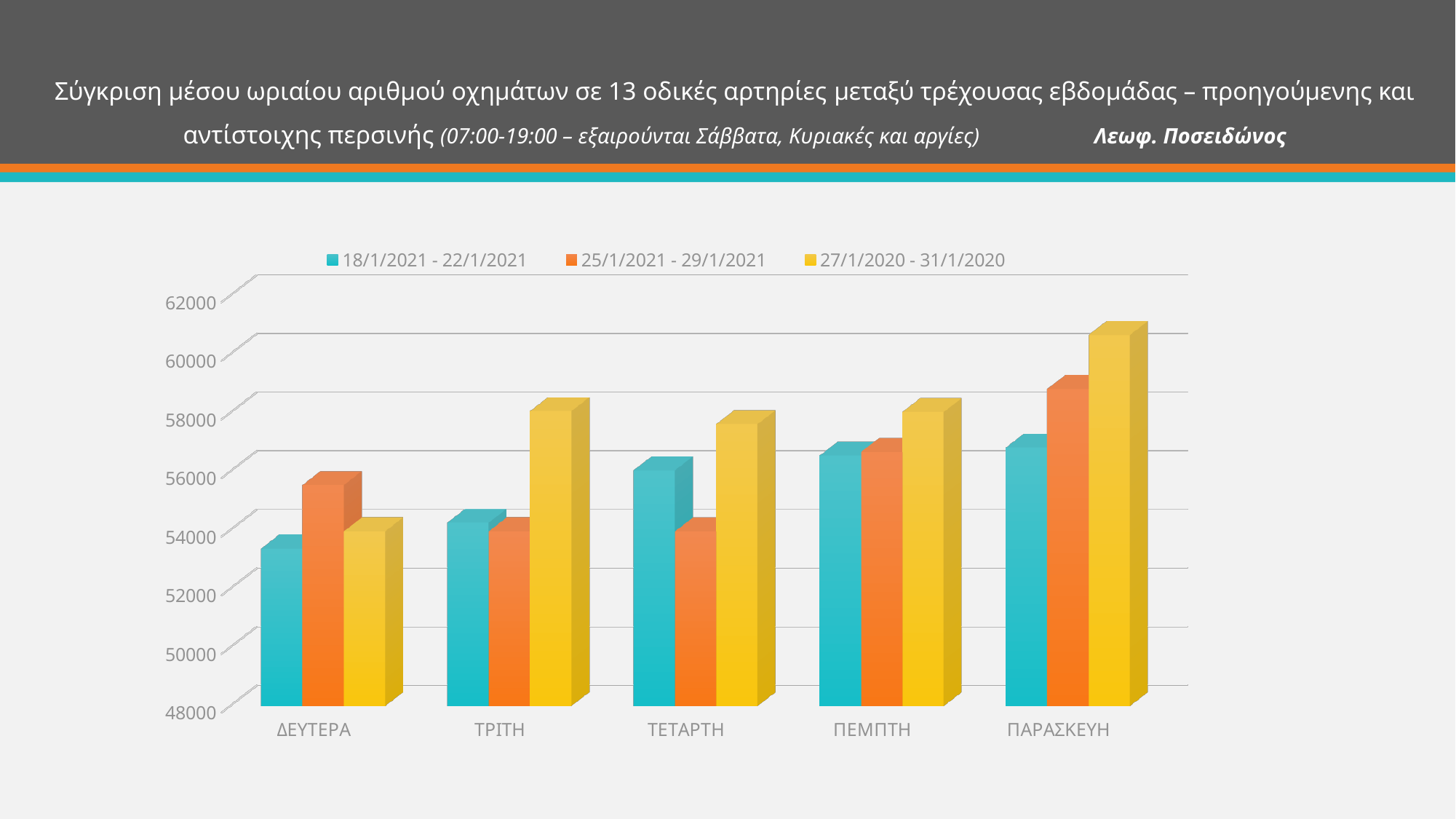
For the series 27/1/2020 - 31/1/2020, which day has the highest value? ΠΑΡΑΣΚΕΥΗ On ΔΕΥΤΕΡΑ, which series has the larger value: 18/1/2021 - 22/1/2021 or 25/1/2021 - 29/1/2021? 25/1/2021 - 29/1/2021 How many categories (days) are shown on the x axis? 5 What kind of chart is shown on the slide? Bar chart For the series 25/1/2021 - 29/1/2021, which day has the highest value? ΠΑΡΑΣΚΕΥΗ Is the value for ΤΕΤΑΡΤΗ in the series 25/1/2021 - 29/1/2021 greater or less than 56000? less Is the value for ΠΑΡΑΣΚΕΥΗ in the series 27/1/2020 - 31/1/2020 greater or less than 60000? greater Which road is named in bold at the end of the slide title? Λεωφ. Ποσειδώνος How many series does the legend list? 3 Do the values for the series 18/1/2021 - 22/1/2021 rise or fall from ΔΕΥΤΕΡΑ to ΠΑΡΑΣΚΕΥΗ? rise For the series 18/1/2021 - 22/1/2021, which day has the lowest value? ΔΕΥΤΕΡΑ Is the value for ΤΡΙΤΗ in the series 27/1/2020 - 31/1/2020 greater or less than 56000? greater